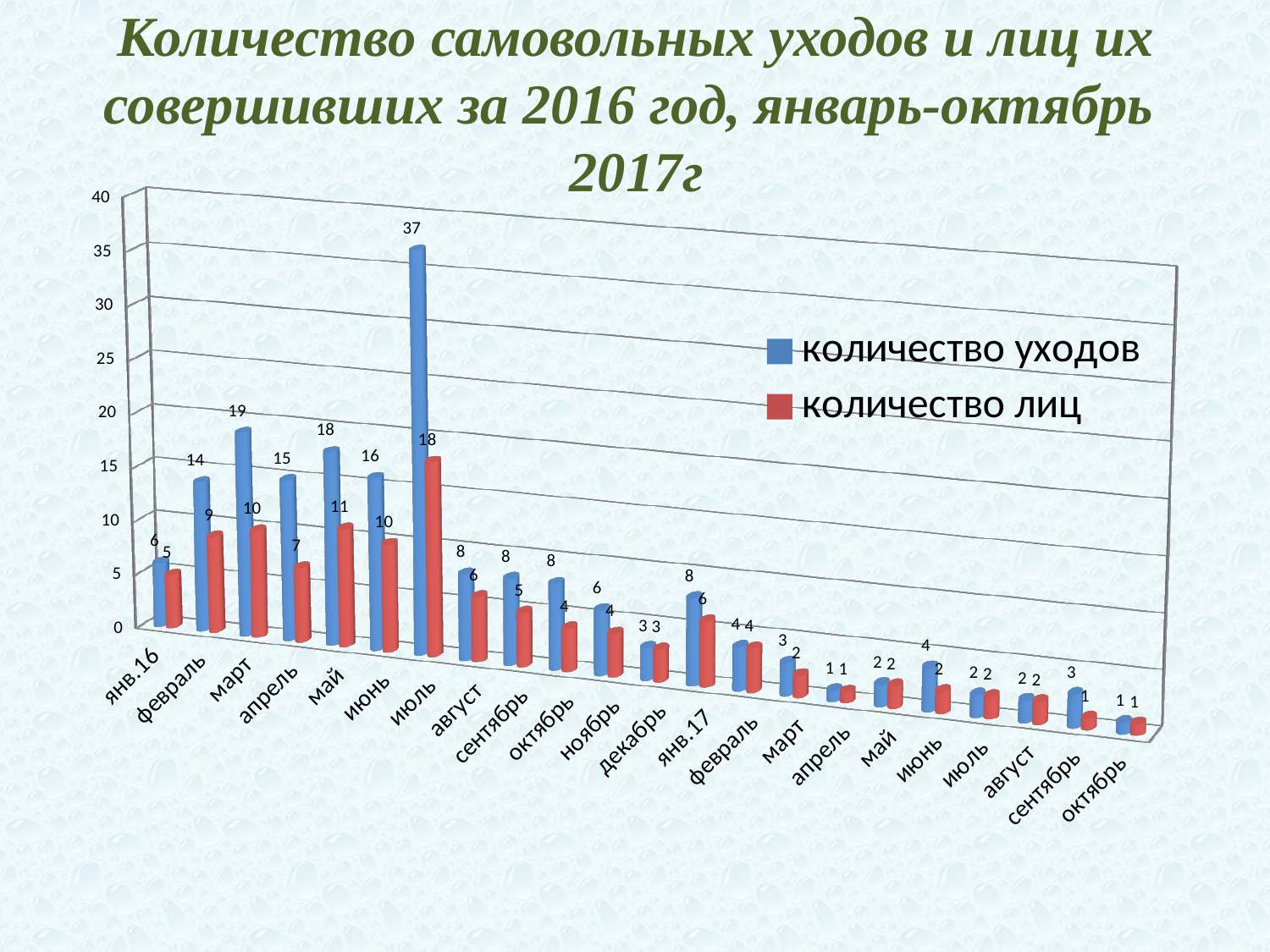
Which month has the highest value of количество уходов? июль 2016 What is the value of количество уходов for март 2016? 19 What is the value of количество лиц for сентябрь 2017? 1 What kind of chart is shown on the slide? bar chart Which colour represents количество лиц in the legend? red What is the value of количество уходов for июль 2016? 37 Is the value of количество уходов for июль 2016 greater or less than 35? greater What is the difference between количество уходов and количество лиц for июль 2016? 19 Which is larger for февраль 2016: количество уходов or количество лиц? количество уходов How many series does the legend list? 2 What is the value of количество лиц for май 2016? 11 How many months (categories) are shown on the x axis? 22